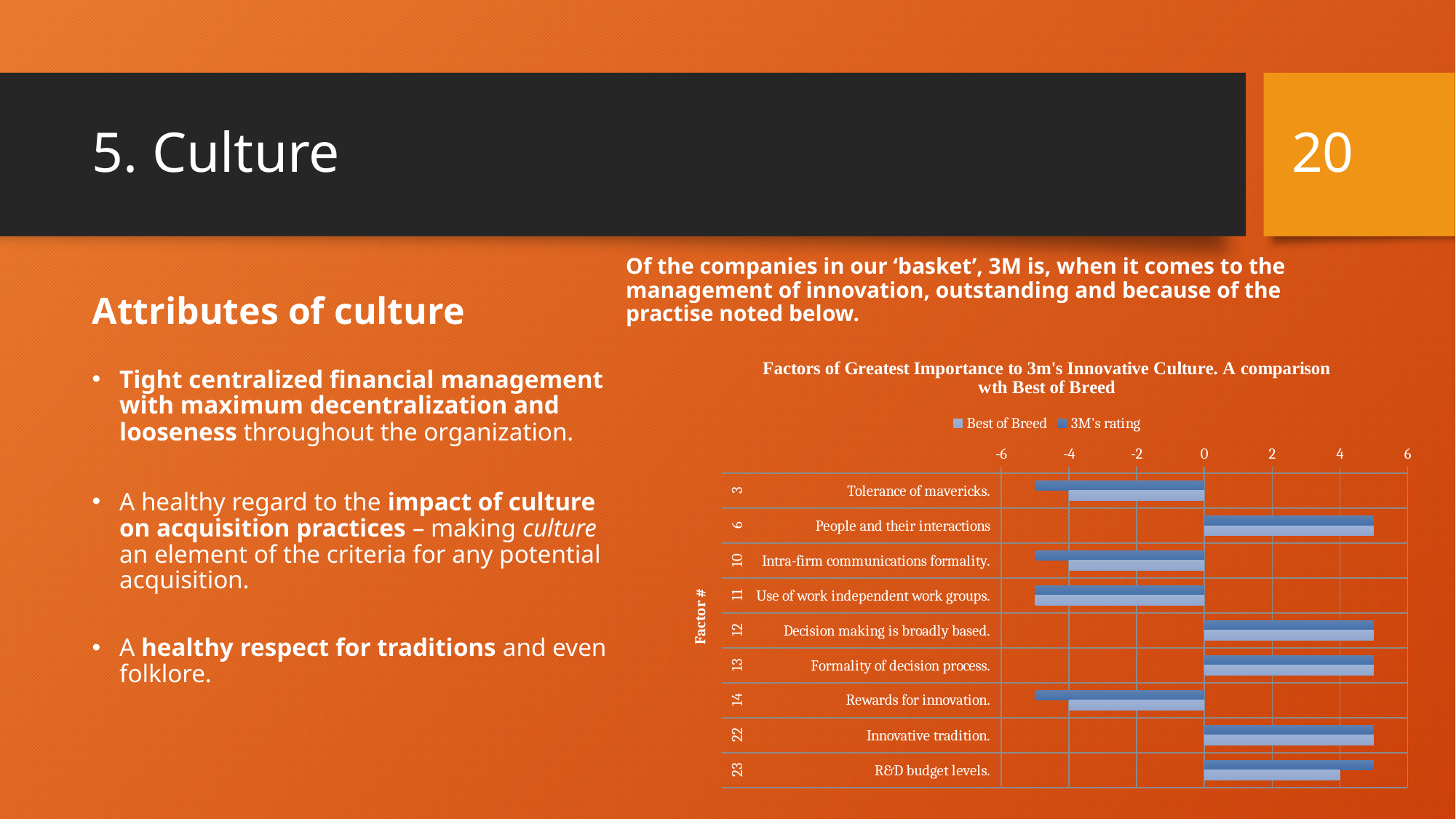
How many series does the chart legend list? 2 For 'Intra-firm communications formality.', which series has the lower (more negative) value, Best of Breed or 3M's rating? 3M's rating Is the 3M's rating value for 'R&D budget levels.' greater or less than 2? greater How many factors (categories) are plotted in the chart? 9 What kind of chart is shown on the slide? Bar chart Which two series are listed in the chart legend? Best of Breed and 3M's rating For 'R&D budget levels.', which series has the larger value, Best of Breed or 3M's rating? 3M's rating Is the 3M's rating value for 'People and their interactions' greater or less than 4? greater What is the title of the vertical axis of the chart? Factor # Is the Best of Breed value for 'Rewards for innovation.' greater or less than 0? less